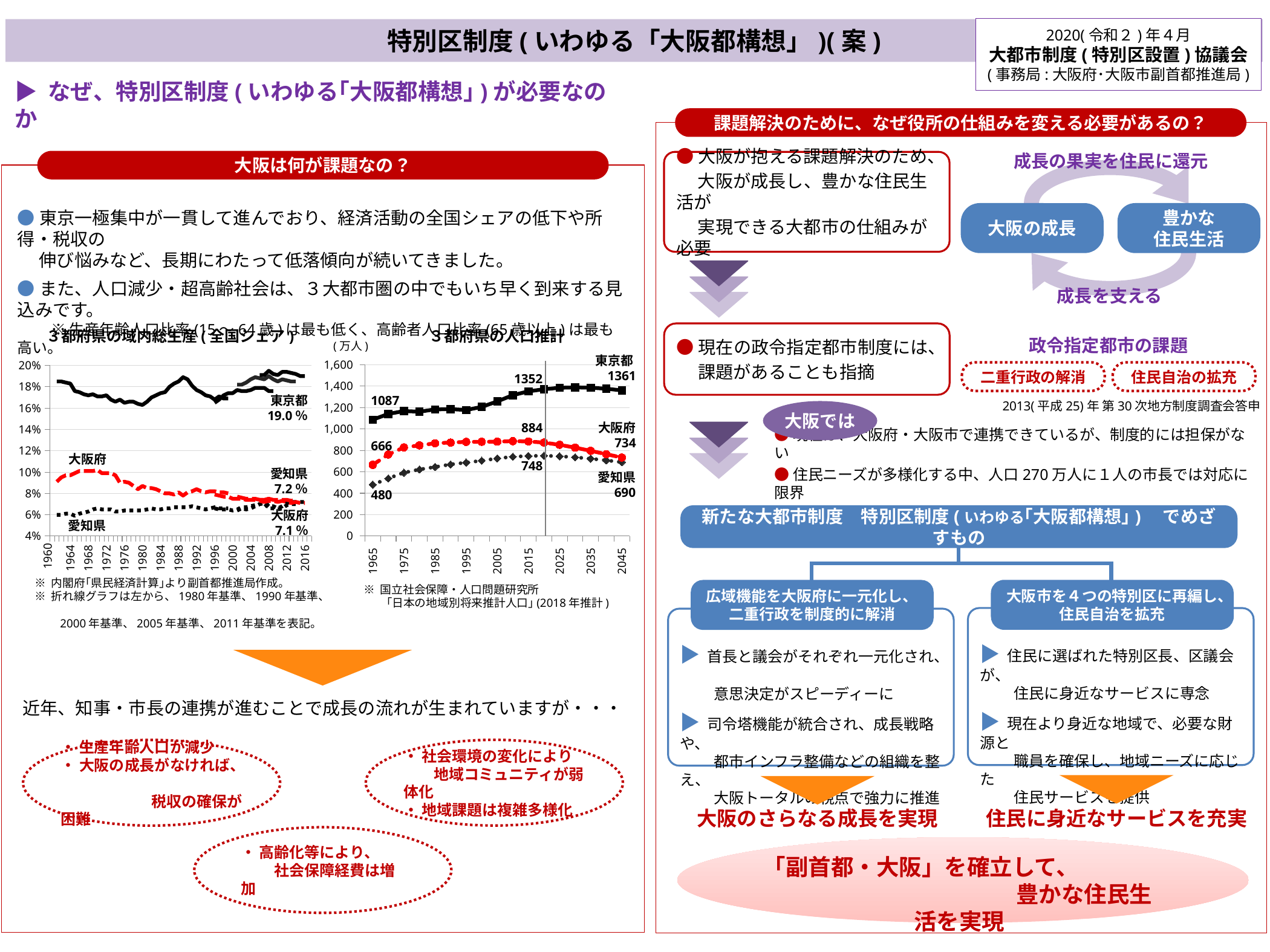
In the chart titled ３都府県の人口推計, what is the labelled value for 大阪府 at 2045? 734 In the chart titled ３都府県の域内総生産(全国シェア), what is the value shown for 大阪府 at the right end of the line? 7.1% What type of chart is the chart titled ３都府県の人口推計? line chart In the chart titled ３都府県の域内総生産(全国シェア), is the value for 大阪府 around 1968 greater or less than 8%? greater In the chart titled ３都府県の域内総生産(全国シェア), which prefecture has the highest share at the right end of the chart? 東京都 In the chart titled ３都府県の人口推計, what is the labelled value for 愛知県 at 1965? 480 In the chart titled ３都府県の域内総生産(全国シェア), what is the value shown for 愛知県 at the right end of the line? 7.2% In the chart titled ３都府県の人口推計, what is the labelled value for 東京都 at 1965? 1087 In the chart titled ３都府県の人口推計, what is the difference between the labelled 愛知県 values at 2045 (690) and 1965 (480)? 210 In the chart titled ３都府県の域内総生産(全国シェア), what is the difference between the labelled end values for 東京都 and 愛知県? 11.8 percentage points In the chart titled ３都府県の域内総生産(全国シェア), what is the value shown for 東京都 at the right end of the line? 19.0% In the chart titled ３都府県の域内総生産(全国シェア), does the 大阪府 line generally rise or fall from 1960 to 2016? fall